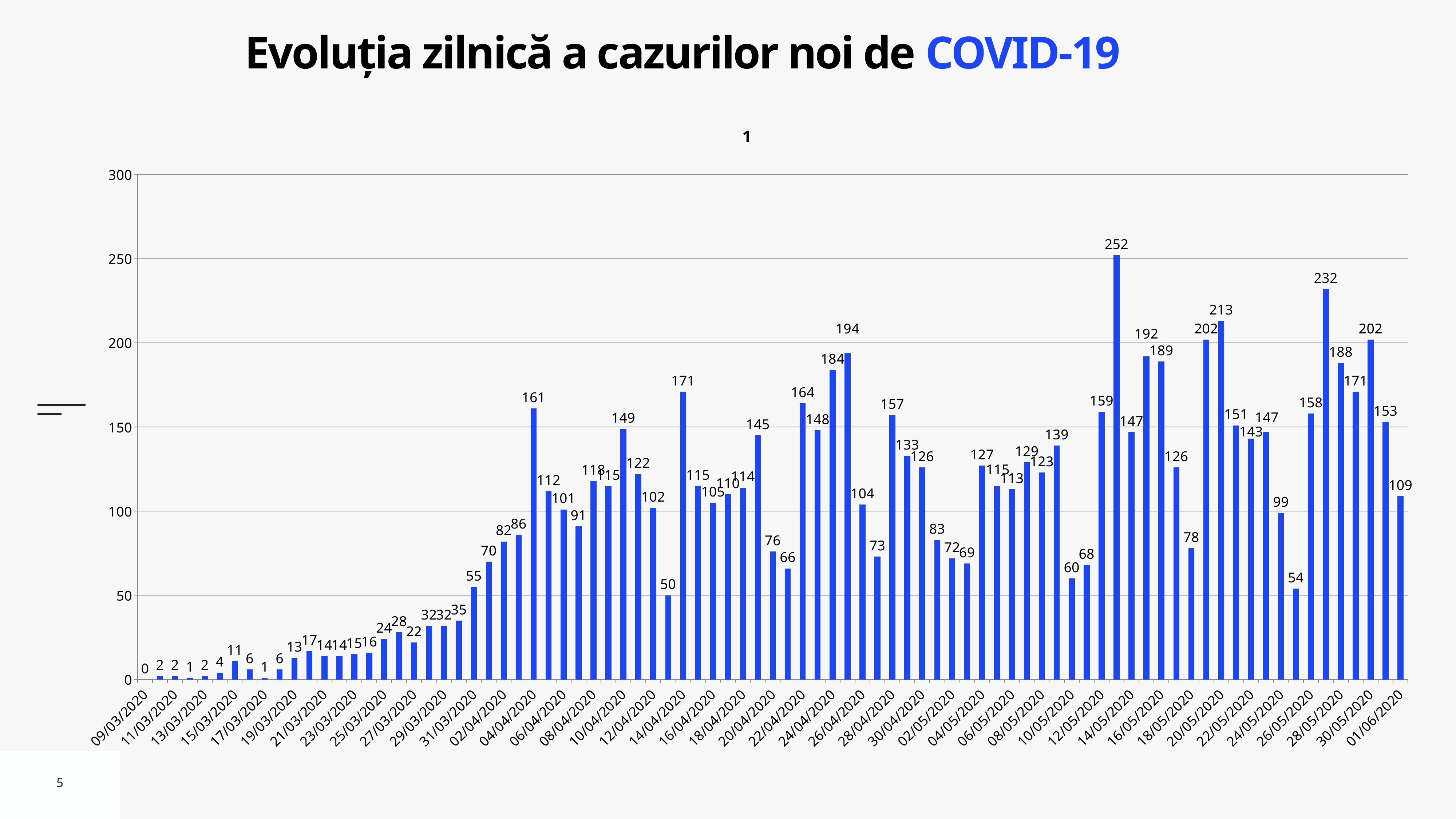
What is the value for 14/04/2020? 171 What is the difference between the values for 20/05/2020 and 12/05/2020? 54 What is the highest daily value shown on the chart? 252 Which date has the lowest value on the chart? 09/03/2020 What is the title of the slide? Evoluția zilnică a cazurilor noi de COVID-19 Do the values generally rise or fall from March to May along the x axis? rise Which is larger, the value for 14/04/2020 or the value for 30/05/2020? 30/05/2020 What kind of chart is shown on the slide? bar chart What is the value for 20/05/2020? 213 What is the value for 31/03/2020? 55 Is the value for 26/05/2020 greater or less than 150? greater What is the value for 01/06/2020? 109